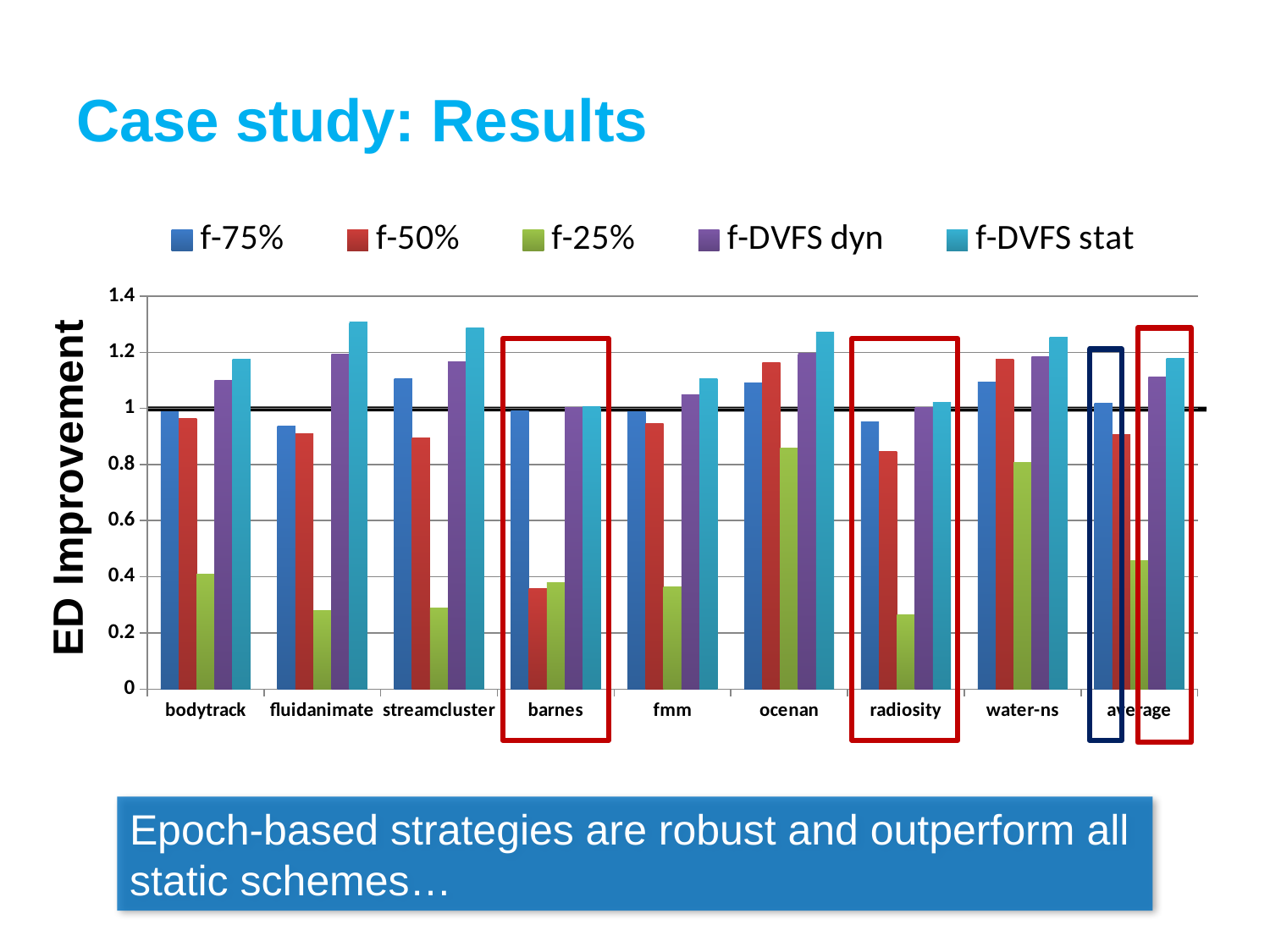
Which series has the lowest value for bodytrack? f-25% Is the f-25% value for radiosity greater or less than 0.4? less Is the f-DVFS stat value for fluidanimate greater or less than 1.2? greater Is the f-25% value for bodytrack greater or less than 0.6? less What kind of chart is shown on the slide? bar chart What is the label of the y axis? ED Improvement For barnes, which is larger: the f-75% value or the f-25% value? f-75% Which series has the highest value for fluidanimate? f-DVFS stat Which colour represents the f-25% series in the legend? green How many categories are shown along the x axis? 9 How many series does the legend list? 5